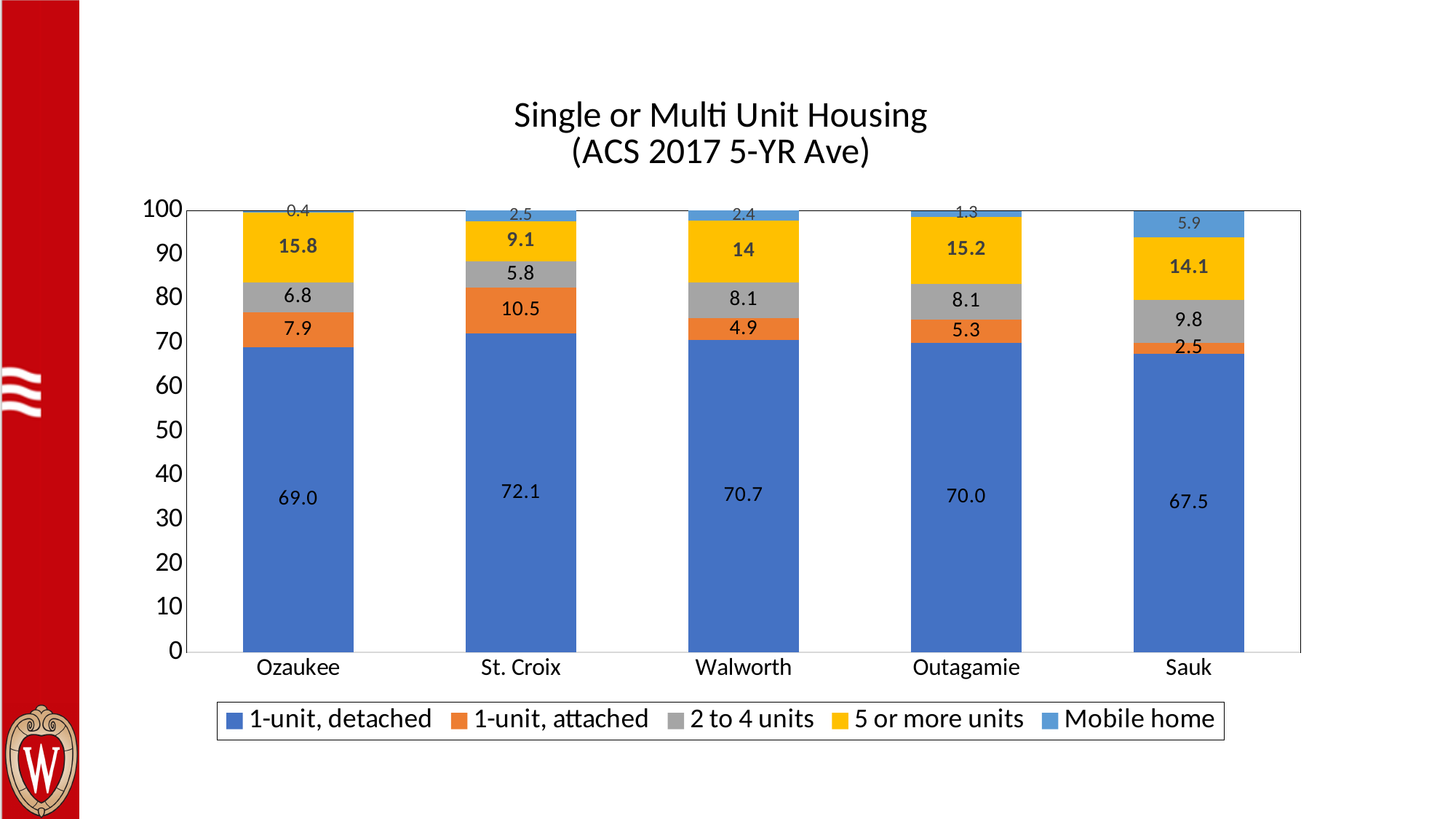
What is the difference between the 1-unit, attached values for St. Croix and Outagamie? 5.2 Which county has the lowest value for 1-unit, attached housing? Sauk Which is larger, the 5 or more units value for Walworth or for Sauk? Sauk What type of chart is shown on the slide? Stacked bar chart What is the title of the chart? Single or Multi Unit Housing (ACS 2017 5-YR Ave) What is the value for Mobile home in Sauk? 5.9 What is the value for 5 or more units in Ozaukee? 15.8 What is the value for 1-unit, detached housing in St. Croix? 72.1 How many counties are shown on the x axis? 5 How many series does the legend list? 5 Which county has the highest value for 1-unit, detached housing? St. Croix What is the value for 2 to 4 units in Walworth? 8.1